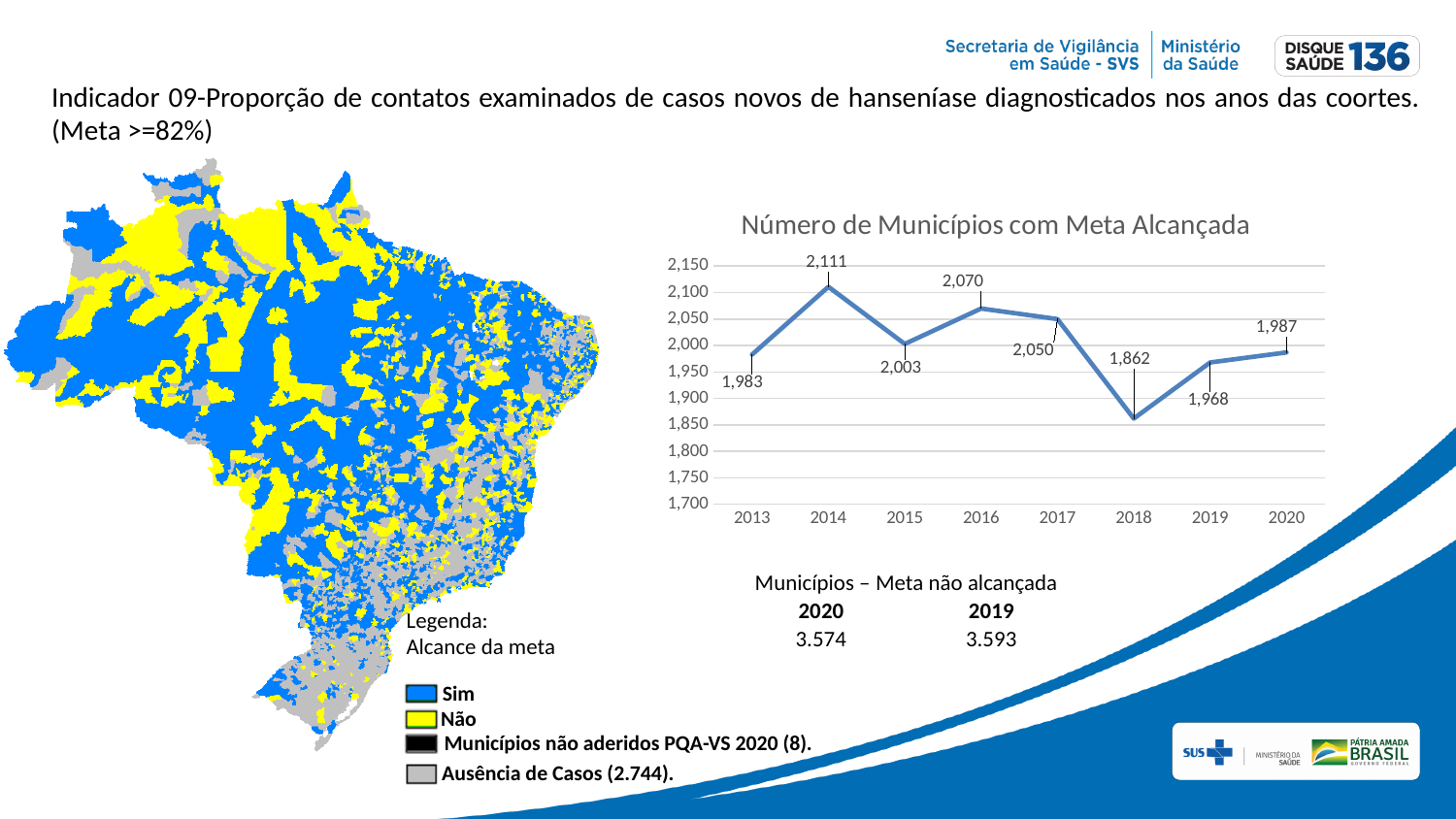
In the chart 'Número de Municípios com Meta Alcançada', what is the value for 2018? 1,862 In the chart 'Número de Municípios com Meta Alcançada', what is the value for 2020? 1,987 In the chart 'Número de Municípios com Meta Alcançada', what is the value for 2014? 2,111 In the chart 'Número de Municípios com Meta Alcançada', which is larger, the value for 2016 or the value for 2017? 2016 In the chart 'Número de Municípios com Meta Alcançada', does the value rise or fall from 2018 to 2020? rise In the chart 'Número de Municípios com Meta Alcançada', which year has the lowest value? 2018 In the chart 'Número de Municípios com Meta Alcançada', what is the difference between the values for 2020 and 2019? 19 In the chart 'Número de Municípios com Meta Alcançada', what is the difference between the values for 2014 and 2018? 249 In the chart 'Número de Municípios com Meta Alcançada', which year has the highest value? 2014 What type of chart is 'Número de Municípios com Meta Alcançada'? line chart In the chart 'Número de Municípios com Meta Alcançada', is the value for 2019 greater or less than 2,000? less How many years are plotted in the chart 'Número de Municípios com Meta Alcançada'? 8